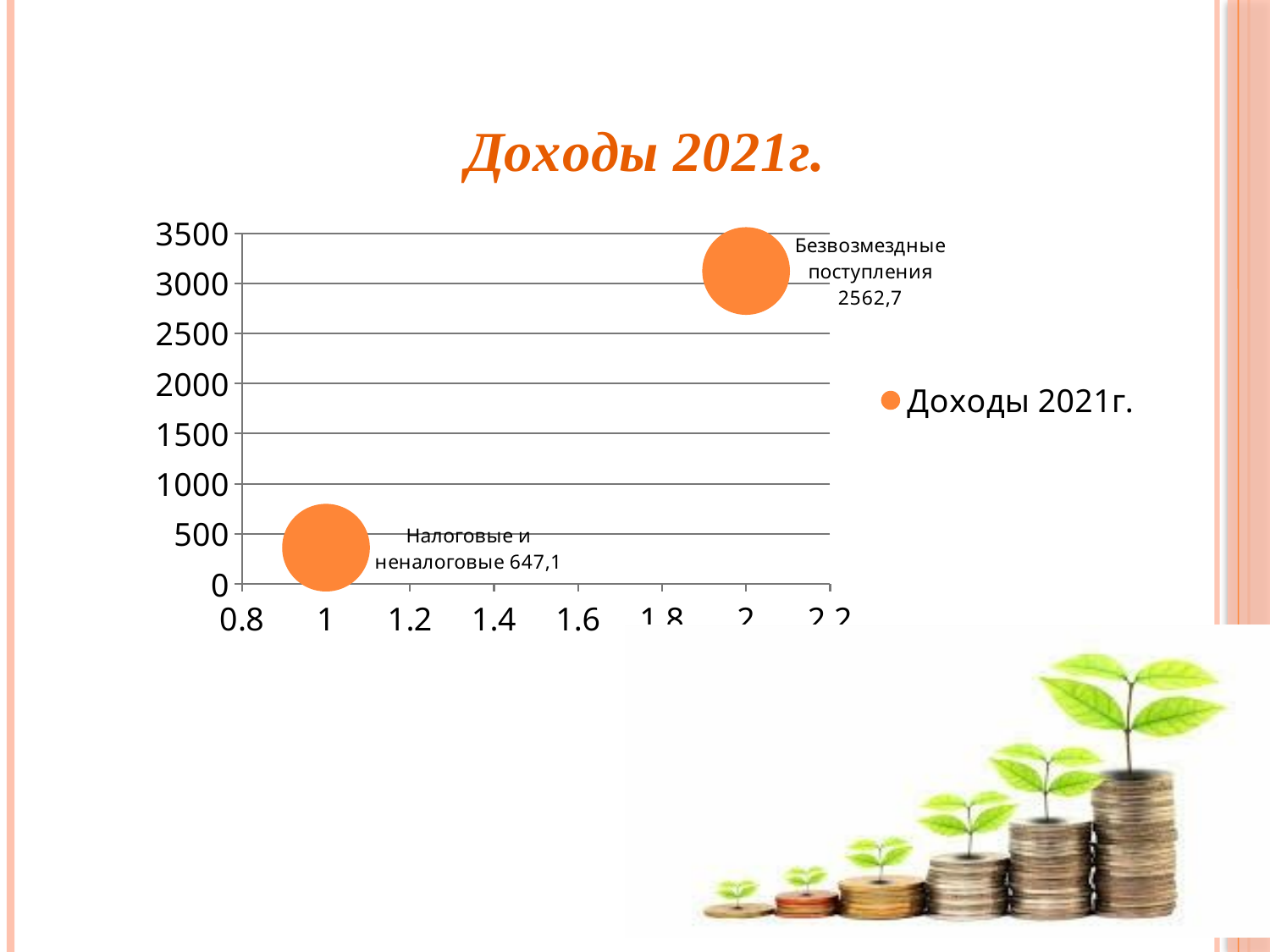
Which category has the highest value? Безвозмездные поступления Which category has the lowest value? Налоговые и неналоговые Is the value for Безвозмездные поступления greater or less than 2500? greater Which is larger: Налоговые и неналоговые or Безвозмездные поступления? Безвозмездные поступления What is the value for Налоговые и неналоговые? 647,1 What is the title of the chart? Доходы 2021г. What is the difference between the values for Безвозмездные поступления and Налоговые и неналоговые? 1915,6 Is the value for Налоговые и неналоговые greater or less than 1000? less What is the value for Безвозмездные поступления? 2562,7 What kind of chart is shown on the slide? bubble chart How many series does the legend list? 1 How many data points (bubbles) are plotted on the chart? 2